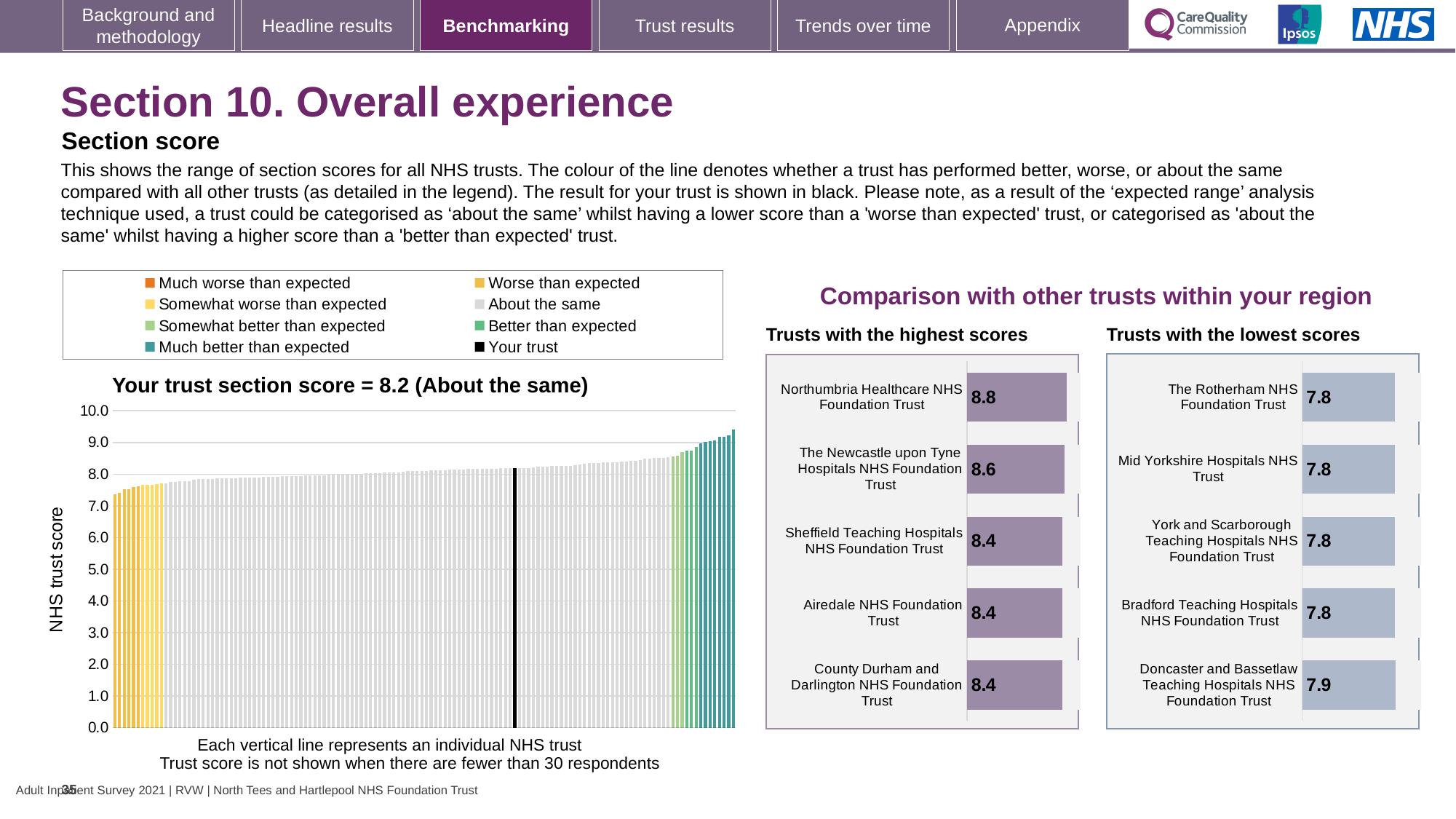
In the 'Trusts with the lowest scores' chart, what is the score for Doncaster and Bassetlaw Teaching Hospitals NHS Foundation Trust? 7.9 How many entries does the legend above the 'Your trust section score' chart list? 8 In the 'Trusts with the highest scores' chart, what is the difference between the scores of Northumbria Healthcare NHS Foundation Trust and The Newcastle upon Tyne Hospitals NHS Foundation Trust? 0.2 In the 'Trusts with the highest scores' chart, what is the score for Northumbria Healthcare NHS Foundation Trust? 8.8 What kind of chart is the 'Your trust section score' chart? bar chart In the 'Your trust section score' chart, is the value of the lowest bar greater or less than 8.0? less How many trusts are shown in the 'Trusts with the lowest scores' chart? 5 In the 'Your trust section score' chart, what is the section score for your trust? 8.2 In the 'Trusts with the highest scores' chart, which trust has the highest score? Northumbria Healthcare NHS Foundation Trust In the 'Your trust section score' chart, which category is your trust placed in? About the same In the 'Your trust section score' chart, is the value of the highest bar greater or less than 9.0? greater Which is larger: the score for Northumbria Healthcare NHS Foundation Trust in the 'Trusts with the highest scores' chart or the score for The Rotherham NHS Foundation Trust in the 'Trusts with the lowest scores' chart? Northumbria Healthcare NHS Foundation Trust